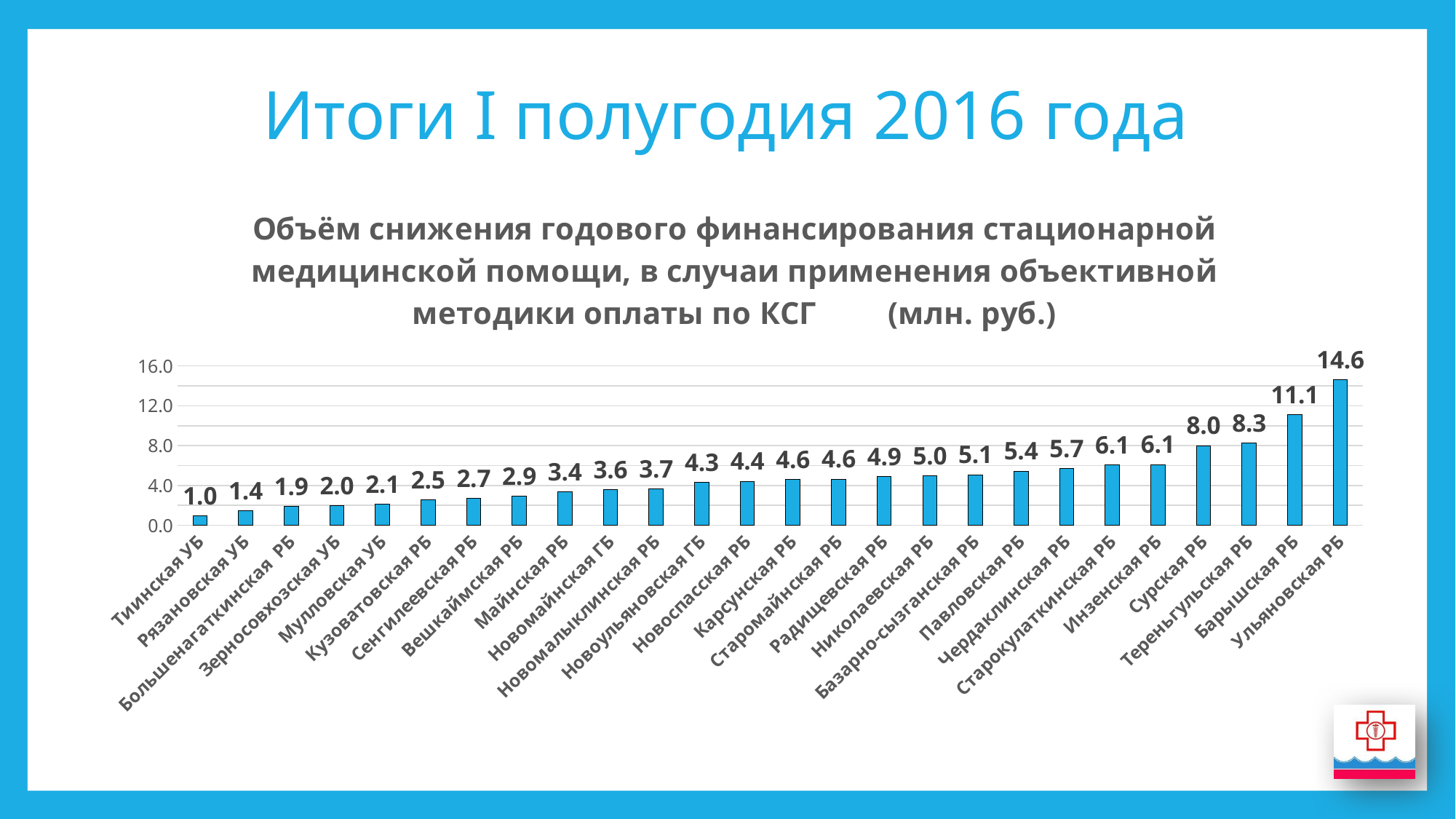
Which category has the highest value? Ульяновская РБ Which category has the lowest value? Тиинская УБ What is the value for Ульяновская РБ? 14.6 Which is larger, the value for Павловская РБ or the value for Чердаклинская РБ? Чердаклинская РБ Do the values rise or fall from left to right along the x axis? rise What is the difference between the values for Тереньгульская РБ and Сурская РБ? 0.3 What is the difference between the values for Ульяновская РБ and Барышская РБ? 3.5 What is the value for Сурская РБ? 8.0 How many categories are shown on the chart? 26 Is the value for Барышская РБ greater or less than 8.0? greater What kind of chart is shown on the slide? bar chart What is the value for Майнская РБ? 3.4